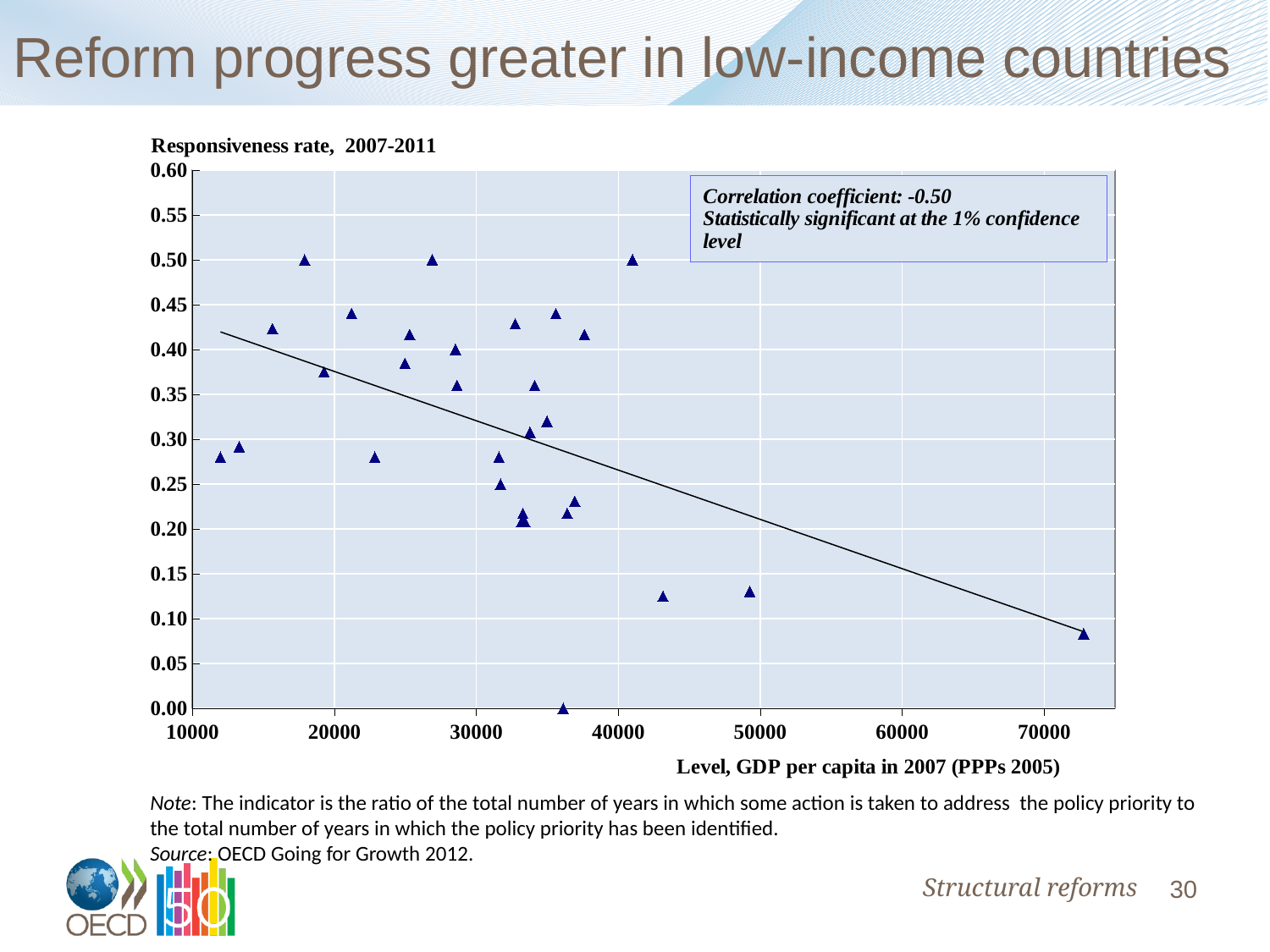
Is the responsiveness rate of the point at roughly 49000 GDP per capita greater or less than 0.20? less What is the lowest responsiveness rate shown by any point on the chart? 0.00 Is the responsiveness rate of the point with the highest GDP per capita (around 72000) greater or less than 0.15? less What kind of chart is shown on the slide? scatter chart Is the responsiveness rate of the point with the lowest GDP per capita (around 12000) greater or less than 0.35? less What is the highest responsiveness rate reached by any point on the chart? 0.50 Does the responsiveness rate tend to rise or fall as GDP per capita increases along the x axis? fall What is the label of the x axis? Level, GDP per capita in 2007 (PPPs 2005) What correlation coefficient is reported in the text box on the chart? -0.50 Which has the higher responsiveness rate: the point at roughly 18000 GDP per capita or the point at roughly 43000 GDP per capita? the point at roughly 18000